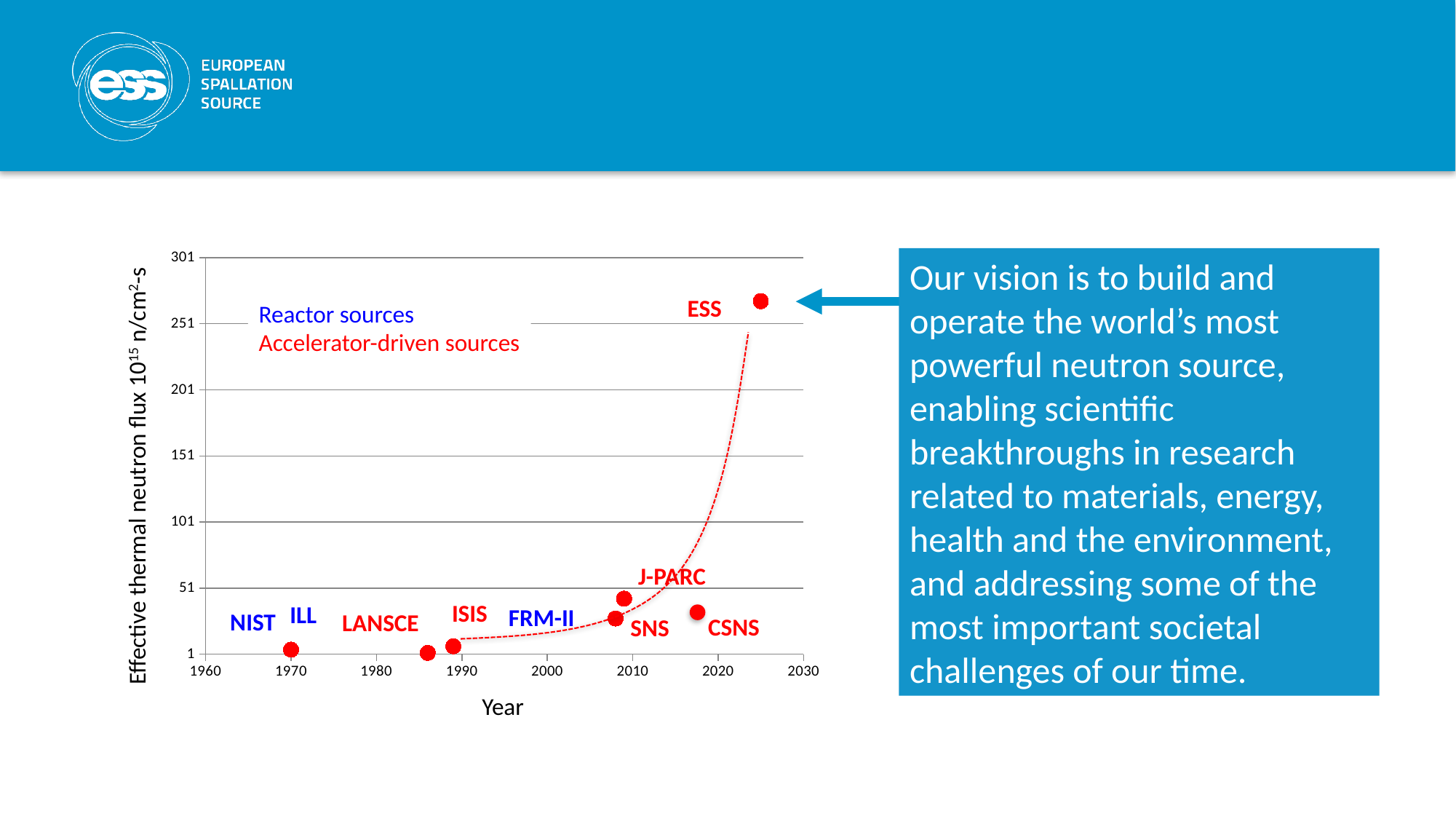
What is the title of the x axis? Year Which has the larger effective thermal neutron flux, J-PARC or LANSCE? J-PARC Which neutron source is plotted at the latest year on the chart? ESS Is the value for ESS greater or less than 251? greater How many named neutron sources are labeled on the chart? 9 Which has the larger effective thermal neutron flux, ESS or J-PARC? ESS Does the effective thermal neutron flux rise or fall as the year increases along the x axis? rise What colour is used for the labels of reactor sources in the chart legend? blue Is the value for CSNS greater or less than 51? less What kind of chart is shown on the slide? scatter chart Which neutron source has the highest effective thermal neutron flux on the chart? ESS Is the value for J-PARC greater or less than 101? less